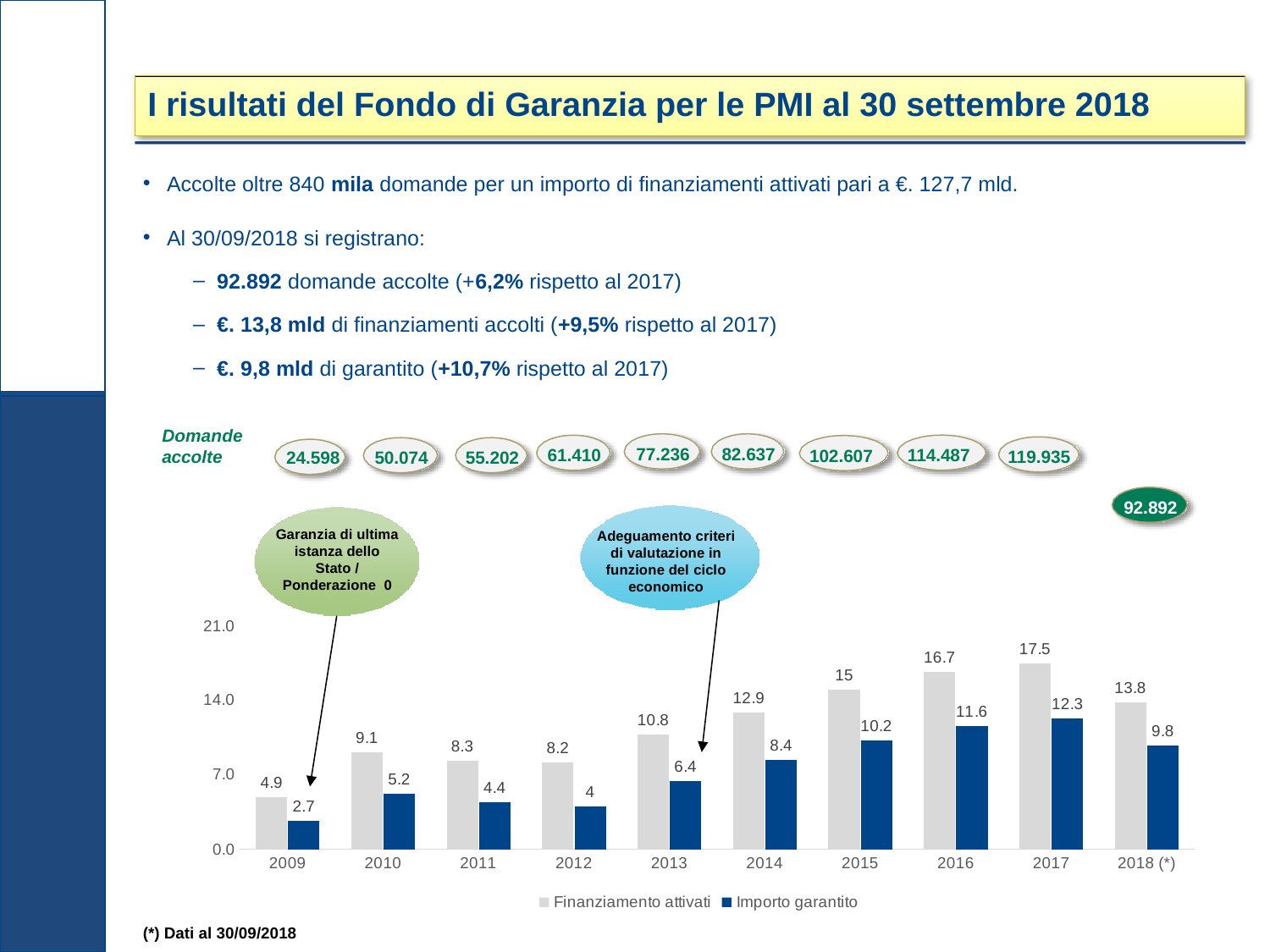
Which year has the highest value for Finanziamento attivati? 2017 What kind of chart is shown on the slide? Bar chart What is the value of Importo garantito for 2018 (*)? 9.8 What is the difference between Finanziamento attivati and Importo garantito in 2016? 5.1 How many years are shown on the x axis of the chart? 10 What is the value of Importo garantito for 2013? 6.4 Which is larger, Finanziamento attivati in 2014 or Finanziamento attivati in 2015? Finanziamento attivati in 2015 Does the value of Importo garantito rise or fall from 2012 to 2017? Rise Is the value of Finanziamento attivati for 2013 greater or less than 7.0? greater How many series does the chart legend list? 2 Which year has the lowest value for Importo garantito? 2009 What is the value of Finanziamento attivati for 2017? 17.5